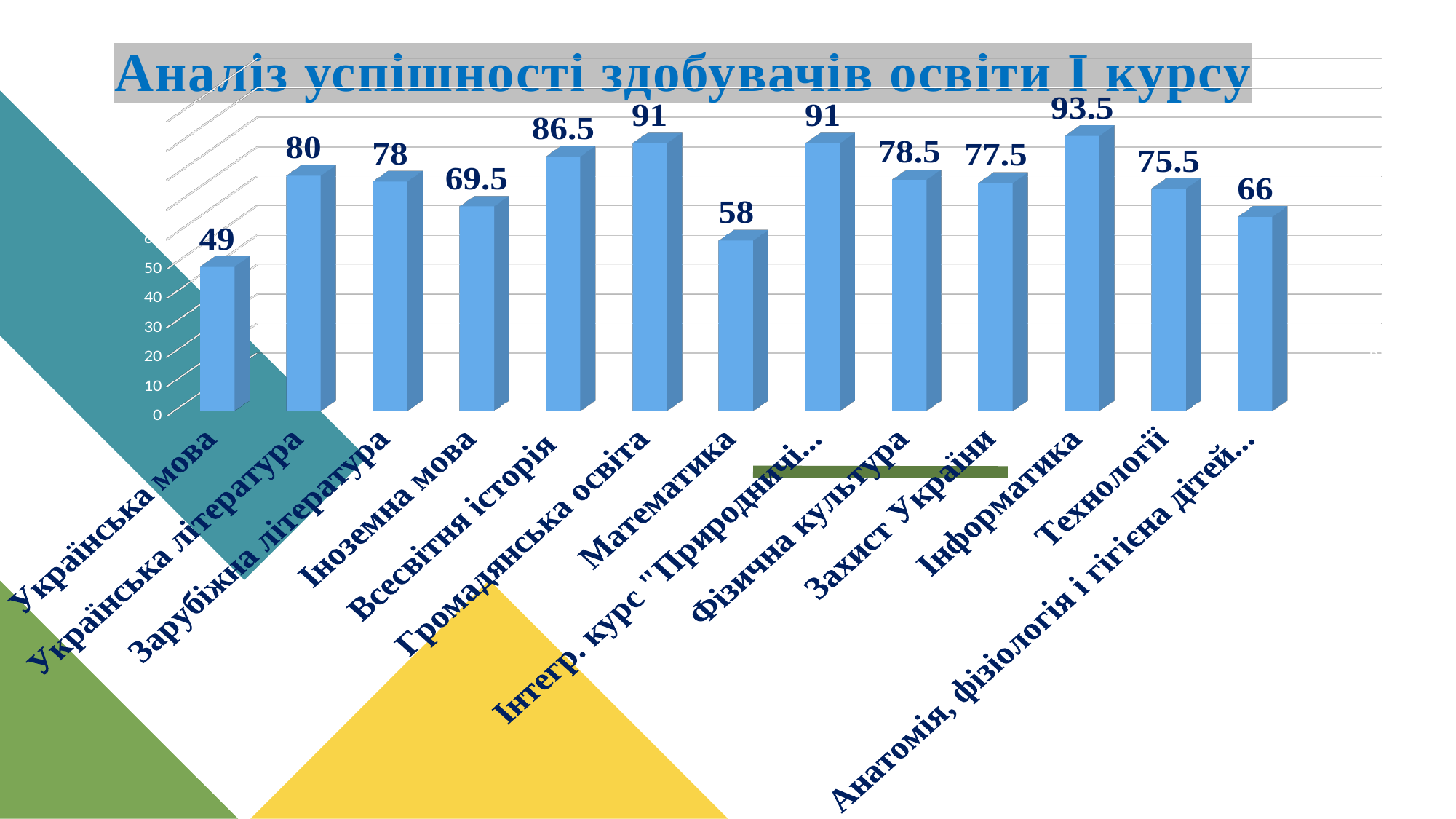
What is the value for Всесвітня історія? 86.5 Which is larger, the value for Фізична культура or the value for Захист України? Фізична культура What kind of chart is shown on the slide? Bar chart What is the difference between the values for Українська література and Зарубіжна література? 2 What is the value for Українська мова? 49 Which category has the lowest value? Українська мова How many categories are shown in the chart? 13 What is the title of the slide? Аналіз успішності здобувачів освіти І курсу What is the value for Інформатика? 93.5 Which category has the highest value? Інформатика What is the difference between the values for Інформатика and Українська мова? 44.5 What is the value for Математика? 58